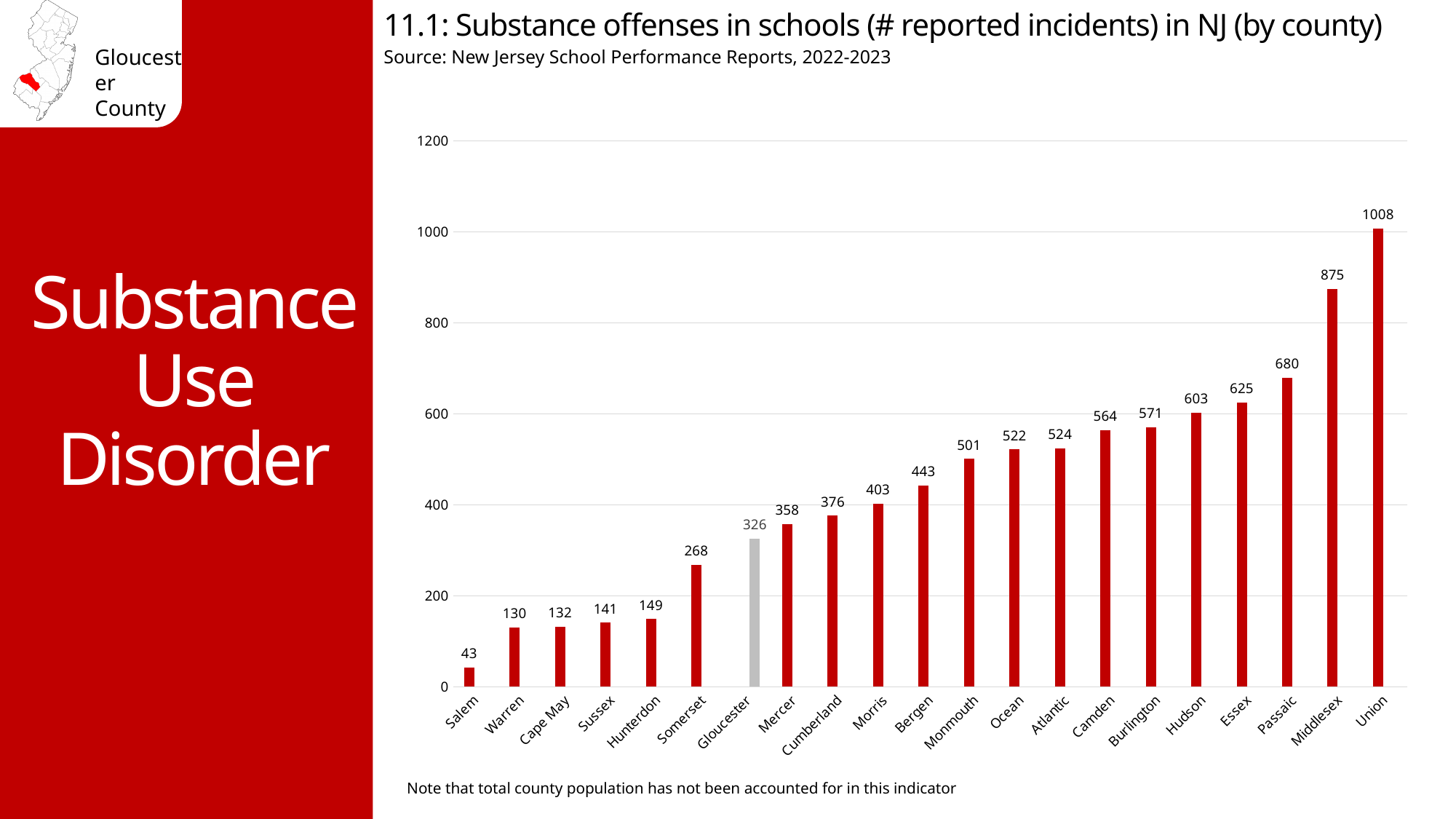
Do the values rise or fall moving from left to right along the x axis? Rise What is the number of reported incidents for Monmouth County? 501 What is the number of reported substance offense incidents in schools for Gloucester County? 326 Is the value for Passaic greater or less than 600? greater Which county's bar is shown in gray rather than red? Gloucester How many counties are shown on the chart? 21 Which county has more reported incidents, Camden or Burlington? Burlington What kind of chart is shown on the slide? Bar chart What is the difference in reported incidents between Gloucester and Somerset? 58 What is the difference in reported incidents between Union and Middlesex? 133 Which county has the lowest number of reported substance offense incidents in schools? Salem Which county has the highest number of reported substance offense incidents in schools? Union